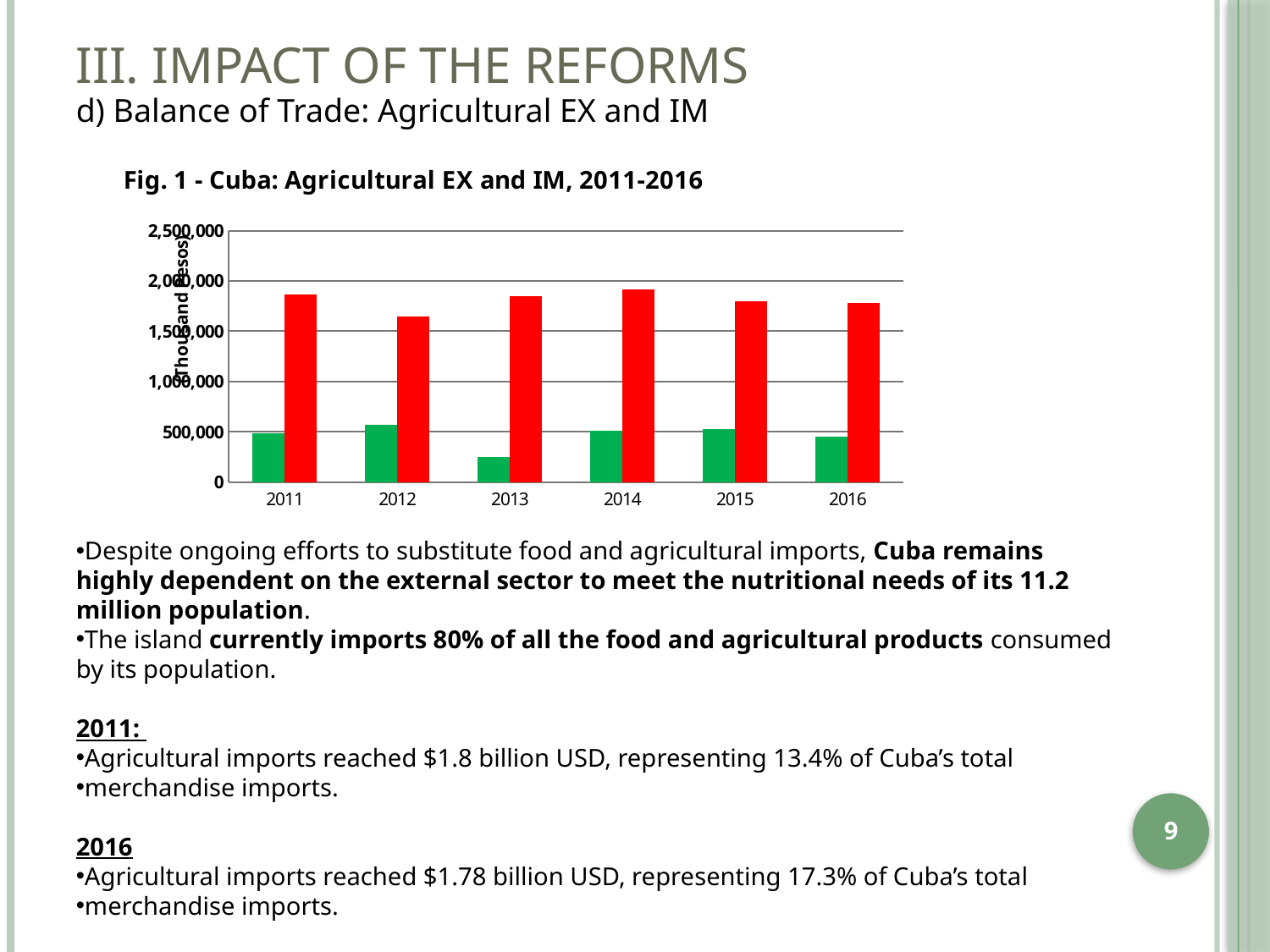
In which year is the red bar the lowest? 2012 Is the value of the red bar for 2012 greater or less than 2,000,000? less Is the value of the red bar for 2011 greater or less than 1,500,000? greater In which year is the red bar the highest? 2014 Is the value of the green bar for 2013 greater or less than 500,000? less For 2011, which bar is larger, the green bar or the red bar? the red bar In which year is the green bar the lowest? 2013 Does the green bar rise or fall from 2012 to 2013? fall What is the label on the vertical axis of the chart? Thousand pesos What kind of chart is shown in Fig. 1? bar chart What is the title of the chart? Fig. 1 - Cuba: Agricultural EX and IM, 2011-2016 How many years are shown on the x axis of the chart? 6